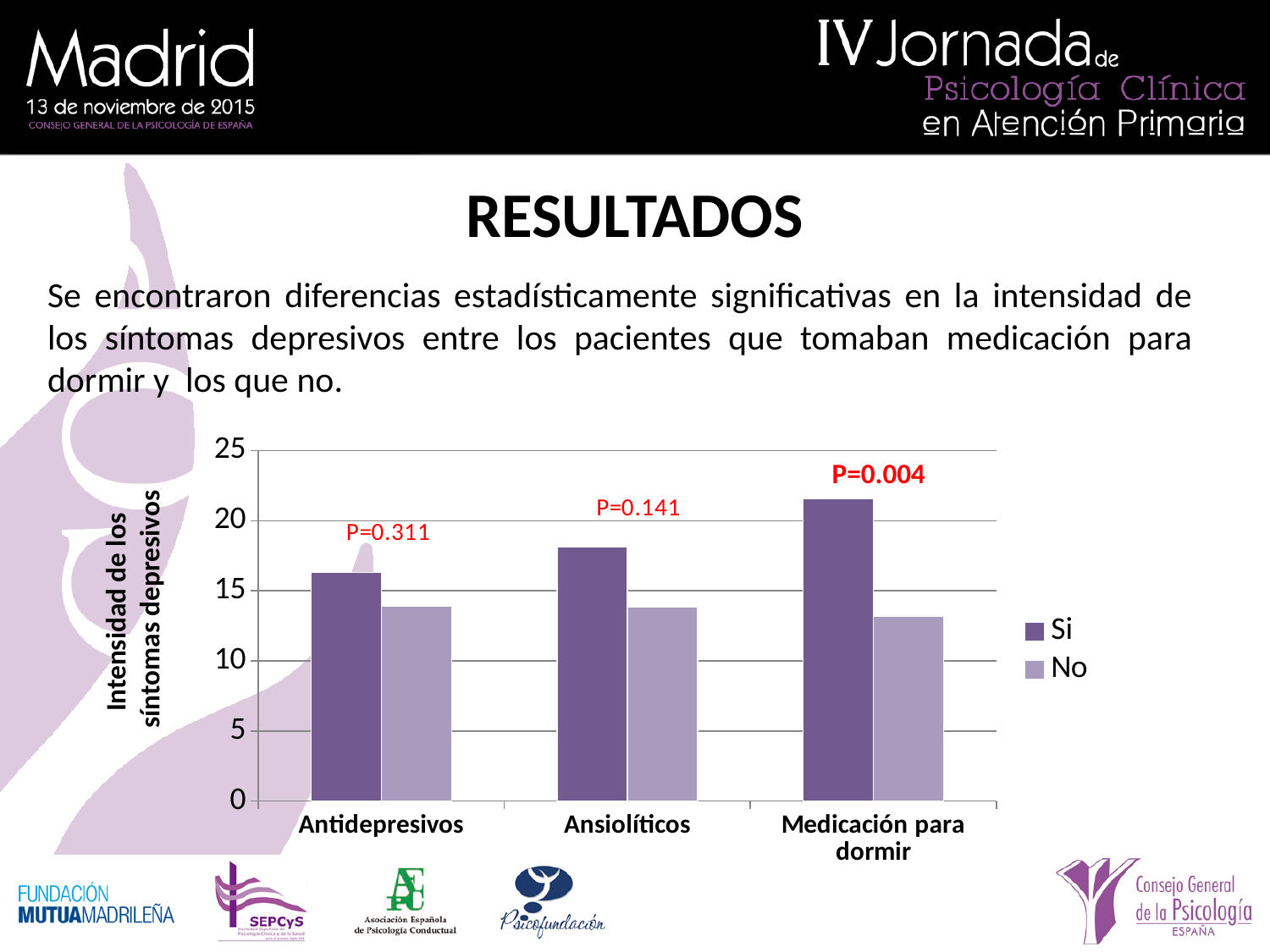
How many series does the chart's legend list? 2 What kind of chart is shown on the slide? bar chart Which category has the lowest value for the 'Si' series? Antidepresivos Is the 'Si' value for 'Ansiolíticos' greater or less than 15? greater Is the 'No' value for 'Antidepresivos' greater or less than 15? less Which category has the highest value for the 'Si' series? Medicación para dormir How many categories are shown on the x axis of the chart? 3 For 'Ansiolíticos', which is larger: the 'Si' bar or the 'No' bar? Si What P-value is printed above the bars for 'Medicación para dormir'? P=0.004 Is the 'Si' value for 'Medicación para dormir' greater or less than 20? greater For 'Medicación para dormir', which is larger: the 'Si' bar or the 'No' bar? Si Do the 'Si' values rise or fall from 'Antidepresivos' to 'Medicación para dormir'? rise